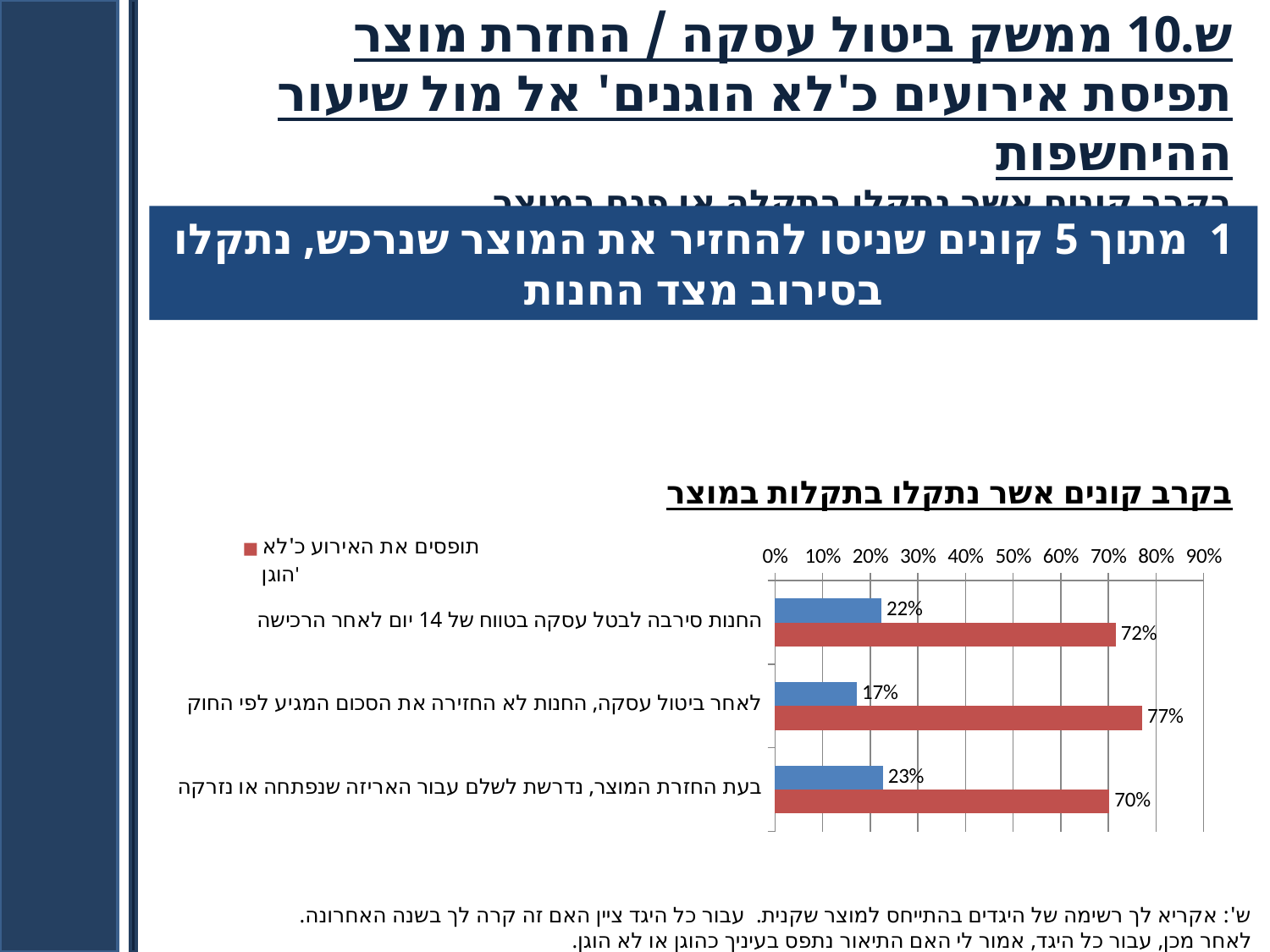
What is the value of the red series ('תופסים את האירוע כ'לא הוגן'') for 'לאחר ביטול עסקה, החנות לא החזירה את הסכום המגיע לפי החוק'? 77% What is the value of the red series for 'בעת החזרת המוצר, נדרשת לשלם עבור האריזה שנפתחה או נזרקה'? 70% What is the value of the blue bar for 'בעת החזרת המוצר, נדרשת לשלם עבור האריזה שנפתחה או נזרקה'? 23% What is the difference between the red and blue values for 'החנות סירבה לבטל עסקה בטווח של 14 יום לאחר הרכישה'? 50% How many categories are shown in the chart? 3 What is the title shown above the chart? בקרב קונים אשר נתקלו בתקלות במוצר Which category has the highest value in the red series? לאחר ביטול עסקה, החנות לא החזירה את הסכום המגיע לפי החוק What is the value of the red series for 'החנות סירבה לבטל עסקה בטווח של 14 יום לאחר הרכישה'? 72% Which is larger: the red value for 'לאחר ביטול עסקה, החנות לא החזירה את הסכום המגיע לפי החוק' or the red value for 'בעת החזרת המוצר, נדרשת לשלם עבור האריזה שנפתחה או נזרקה'? לאחר ביטול עסקה, החנות לא החזירה את הסכום המגיע לפי החוק Which category has the lowest value in the blue series? לאחר ביטול עסקה, החנות לא החזירה את הסכום המגיע לפי החוק What is the value of the blue bar for 'לאחר ביטול עסקה, החנות לא החזירה את הסכום המגיע לפי החוק'? 17% What type of chart is shown on the slide? Bar chart